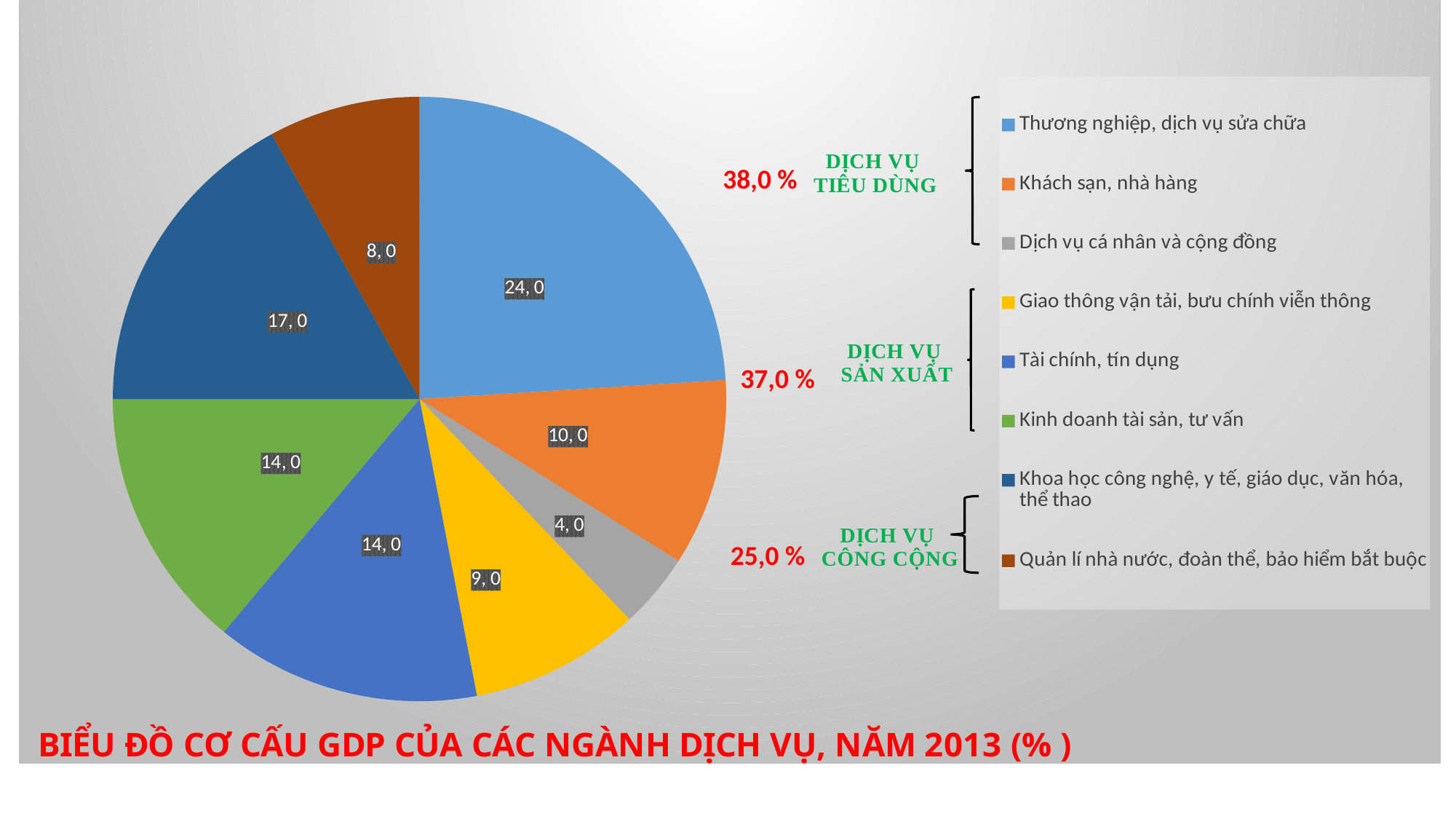
Which category has the smallest slice of the pie? Dịch vụ cá nhân và cộng đồng What is the difference between the values for Thương nghiệp, dịch vụ sửa chữa and Khoa học công nghệ, y tế, giáo dục, văn hóa, thể thao? 7,0 What percentage is shown for the Dịch vụ sản xuất group? 37,0 % What is the value for Thương nghiệp, dịch vụ sửa chữa? 24,0 What kind of chart is shown on the slide? pie chart Which category has the largest slice of the pie? Thương nghiệp, dịch vụ sửa chữa How many categories does the legend list? 8 What is the title of the chart? BIỂU ĐỒ CƠ CẤU GDP CỦA CÁC NGÀNH DỊCH VỤ, NĂM 2013 (% ) What is the value for Khoa học công nghệ, y tế, giáo dục, văn hóa, thể thao? 17,0 Which is larger, the value for Giao thông vận tải, bưu chính viễn thông or the value for Khách sạn, nhà hàng? Khách sạn, nhà hàng What is the value for Khách sạn, nhà hàng? 10,0 What is the value for Quản lí nhà nước, đoàn thể, bảo hiểm bắt buộc? 8,0